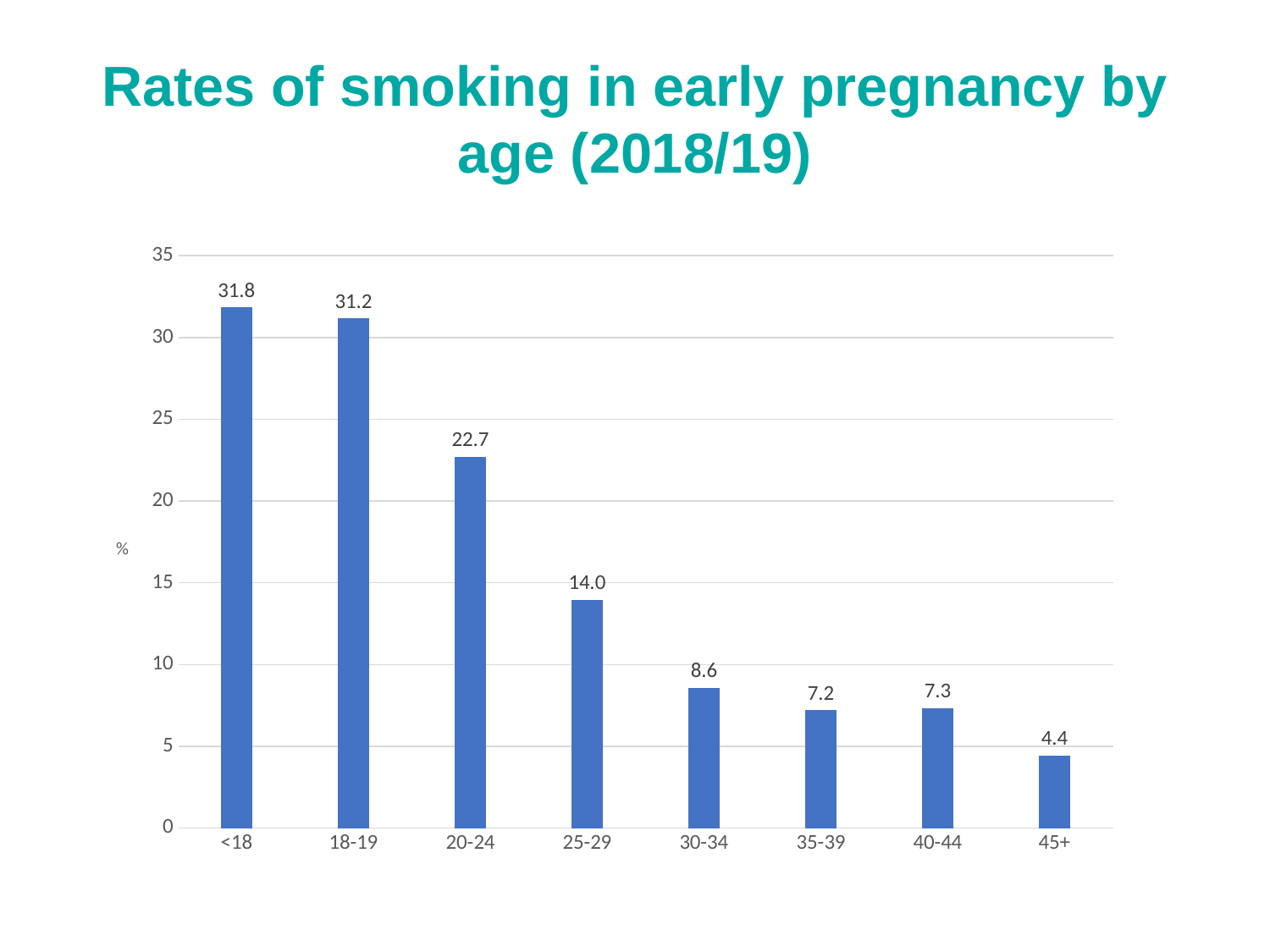
How many age groups are shown on the chart? 8 What is the rate of smoking in early pregnancy for the <18 age group? 31.8 Which is larger, the value for 30-34 or the value for 35-39? 30-34 What kind of chart is shown on the slide? bar chart What is the difference between the values for the 20-24 and 25-29 age groups? 8.7 What is the value shown for the 20-24 age group? 22.7 Which age group has the highest rate of smoking in early pregnancy? <18 What is the difference between the values for the <18 and 45+ age groups? 27.4 What is the title of the chart? Rates of smoking in early pregnancy by age (2018/19) What is the value shown for the 45+ age group? 4.4 Which age group has the lowest rate of smoking in early pregnancy? 45+ Is the value for the 25-29 age group greater or less than 15? less